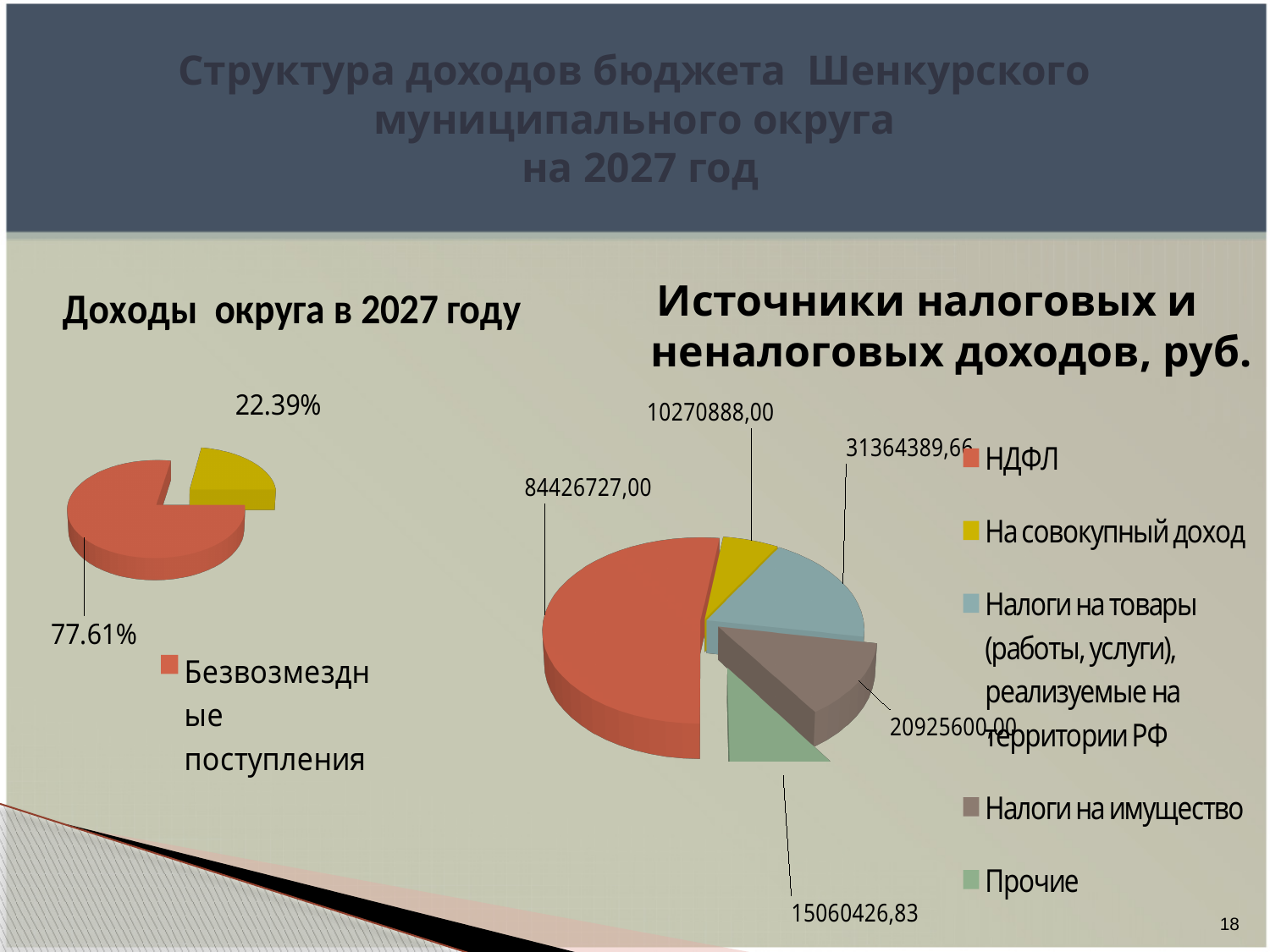
In the left chart 'Доходы округа в 2027 году', what is the value of the smaller (yellow) slice? 22.39% In the right chart 'Источники налоговых и неналоговых доходов, руб.', what is the value for Налоги на имущество? 20925600,00 How many categories does the legend of the right chart 'Источники налоговых и неналоговых доходов, руб.' list? 5 In the right chart 'Источники налоговых и неналоговых доходов, руб.', what is the difference between Налоги на имущество and На совокупный доход? 10654712,00 In the right chart 'Источники налоговых и неналоговых доходов, руб.', which category has the highest value? НДФЛ In the right chart 'Источники налоговых и неналоговых доходов, руб.', what is the value for НДФЛ? 84426727,00 In the right chart 'Источники налоговых и неналоговых доходов, руб.', what is the value for Прочие? 15060426,83 How many slices does the left chart 'Доходы округа в 2027 году' have? 2 In the right chart 'Источники налоговых и неналоговых доходов, руб.', which is larger: Налоги на товары (работы, услуги), реализуемые на территории РФ or Прочие? Налоги на товары (работы, услуги), реализуемые на территории РФ In the left chart 'Доходы округа в 2027 году', what is the value for Безвозмездные поступления? 77.61% What kind of chart is the left chart titled 'Доходы округа в 2027 году'? pie chart In the right chart 'Источники налоговых и неналоговых доходов, руб.', which category has the lowest value? На совокупный доход